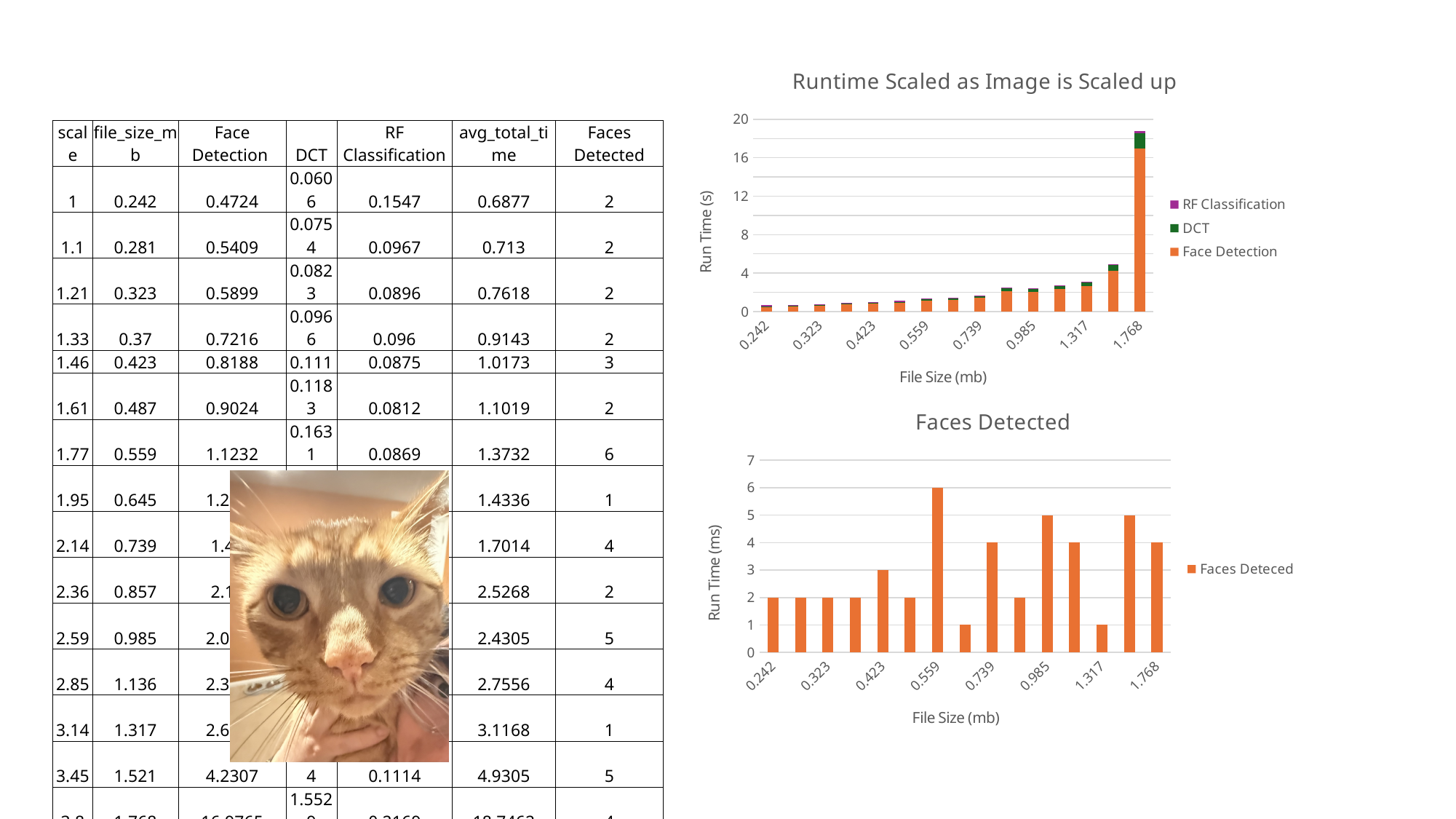
In the 'Faces Detected' chart, which file size has the highest number of faces detected? 0.559 How many series does the legend of the 'Runtime Scaled as Image is Scaled up' chart list? 3 In the 'Faces Detected' chart, which is larger: the value for 0.739 or the value for 1.317? 0.739 In the 'Runtime Scaled as Image is Scaled up' chart, which series is shown in orange? Face Detection In the 'Runtime Scaled as Image is Scaled up' chart, is the total run time for file size 1.768 greater or less than 16? greater In the 'Faces Detected' chart, what is the value for file size 1.317? 1 How many bars are plotted in the 'Faces Detected' chart? 15 What type of chart is the 'Faces Detected' chart? bar chart In the 'Faces Detected' chart, what is the value for file size 0.985? 5 In the 'Runtime Scaled as Image is Scaled up' chart, is the total run time for file size 1.317 greater or less than 4? less In the 'Faces Detected' chart, what is the value for file size 0.559? 6 In the 'Faces Detected' chart, what is the difference between the values for file sizes 0.559 and 0.423? 3